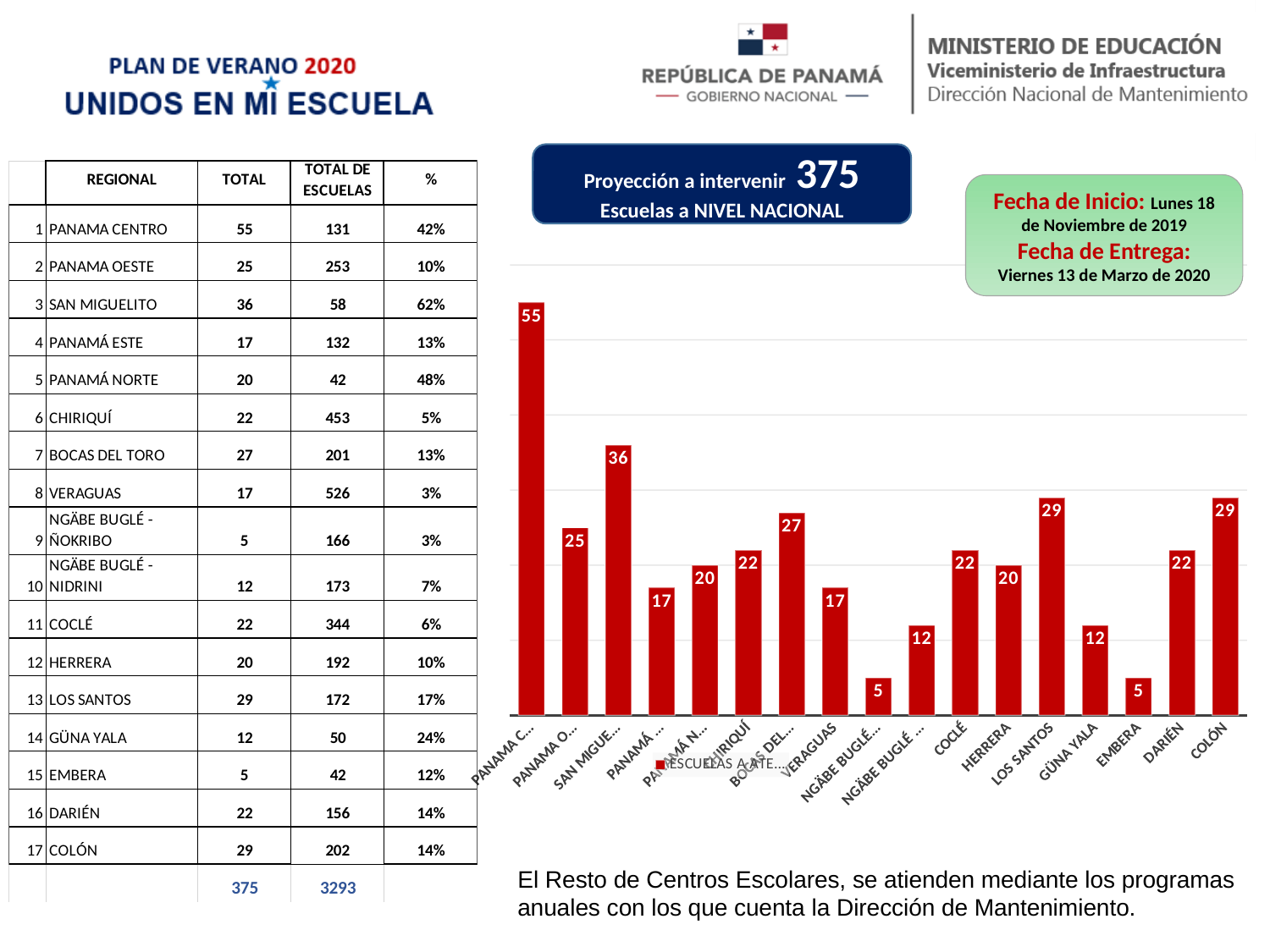
What is the value shown for GÜNA YALA in the chart? 12 How many bars (regions) are plotted in the chart? 17 Which has a larger value in the chart, LOS SANTOS or HERRERA? LOS SANTOS What type of chart is shown on the slide? bar chart What is the lowest value shown on any bar in the chart? 5 What is the value shown for EMBERA in the chart? 5 What is the highest value shown on any bar in the chart? 55 What colour are the bars in the chart? red What is the value shown for LOS SANTOS in the chart? 29 What is the value shown for CHIRIQUÍ in the chart? 22 What is the value shown for VERAGUAS in the chart? 17 What is the difference between the values for COLÓN and COCLÉ in the chart? 7